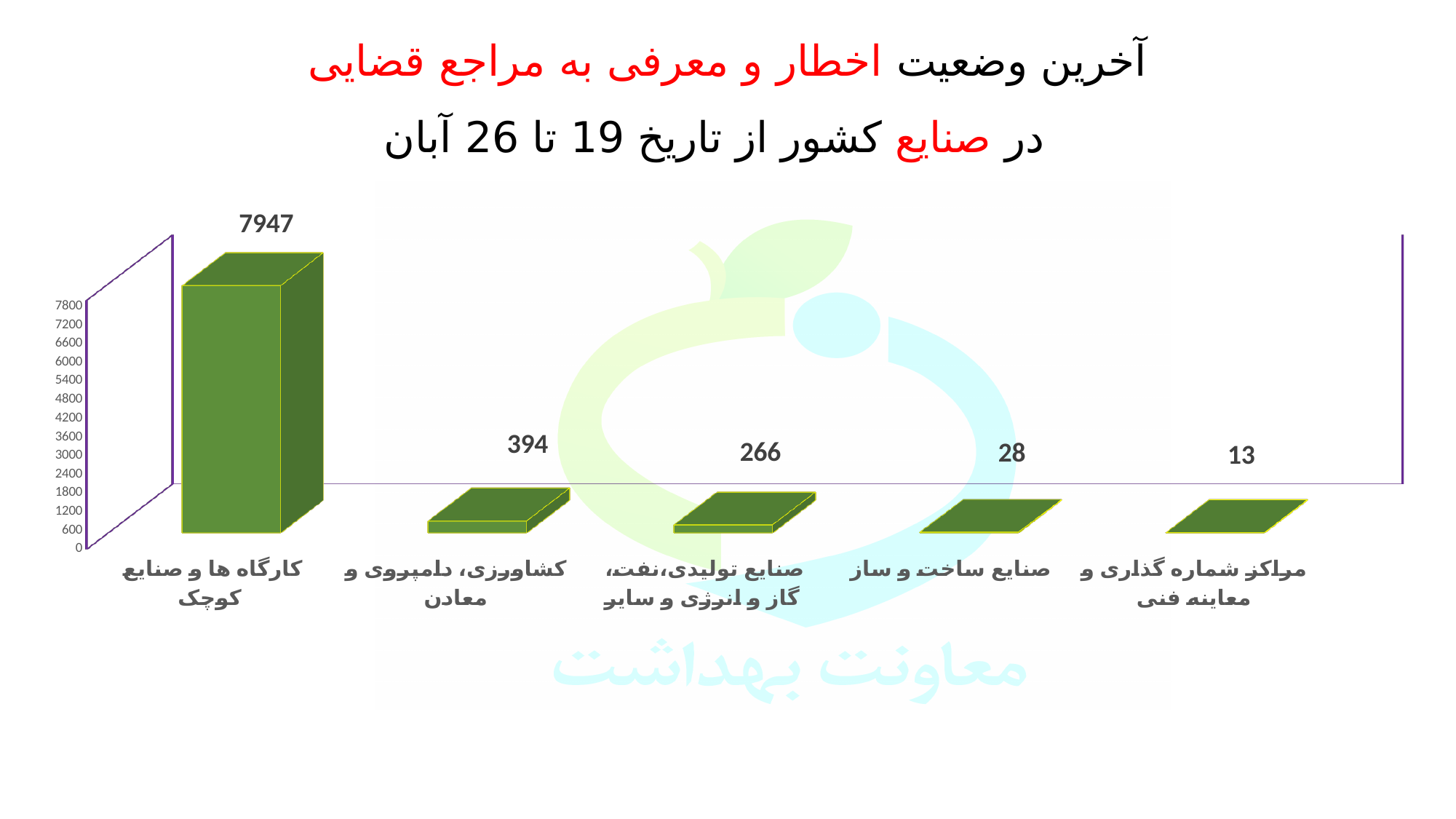
What is the value for کارگاه ها و صنایع کوچک? 7947 How many categories are shown in the chart? 5 Which category has the lowest value? مراکز شماره گذاری و معاینه فنی Which is larger, the value for صنایع ساخت و ساز or the value for مراکز شماره گذاری و معاینه فنی? صنایع ساخت و ساز What is the value for مراکز شماره گذاری و معاینه فنی? 13 What is the difference between the values for کارگاه ها و صنایع کوچک and کشاورزی، دامپروری و معادن? 7553 What is the value for صنایع تولیدی، نفت، گاز و انرژی و سایر? 266 What kind of chart is shown on the slide? bar chart What is the value for کشاورزی، دامپروری و معادن? 394 Which category has the highest value? کارگاه ها و صنایع کوچک What is the difference between the values for کشاورزی، دامپروری و معادن and صنایع تولیدی، نفت، گاز و انرژی و سایر? 128 What is the value for صنایع ساخت و ساز? 28